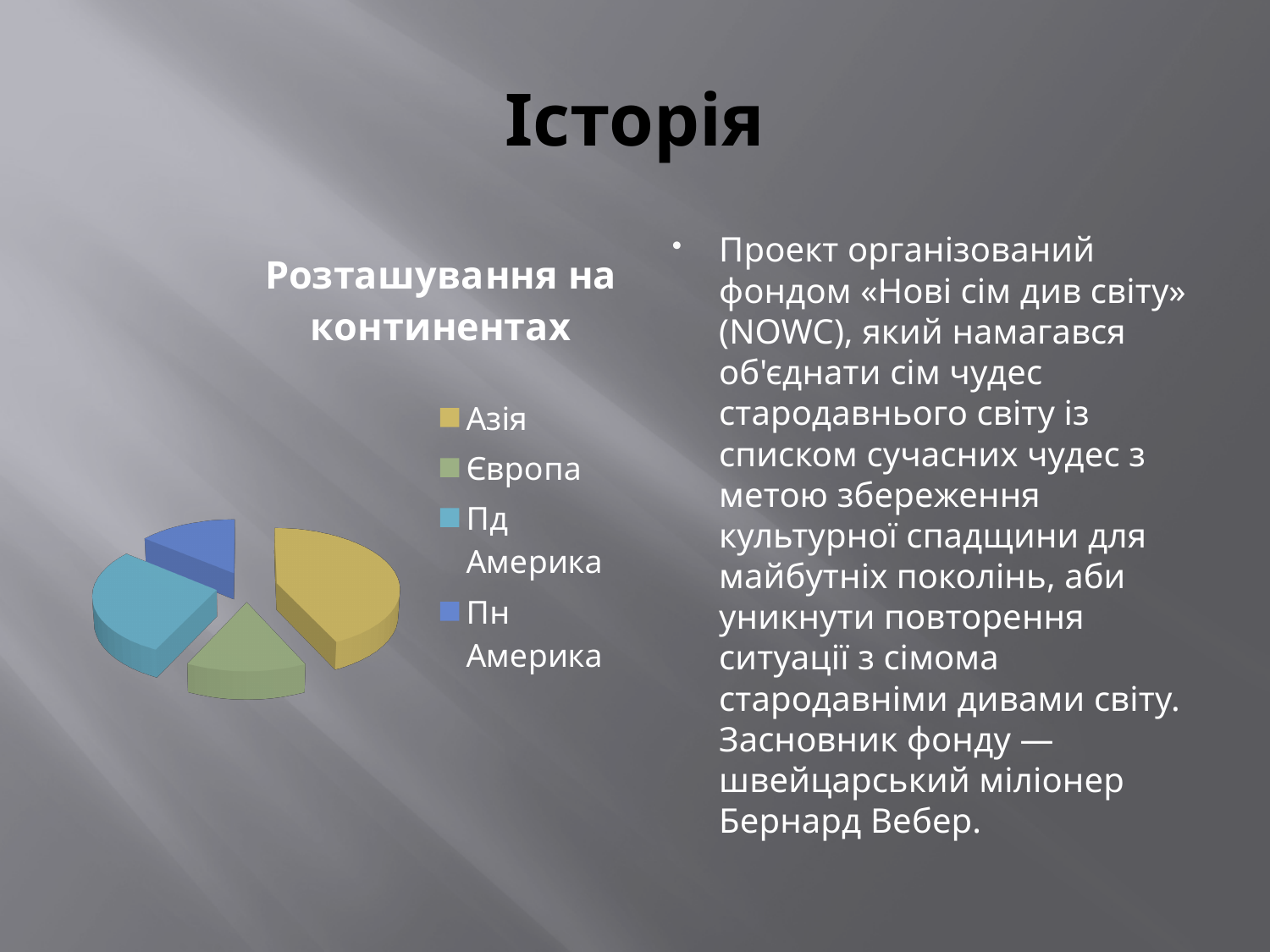
Which slice is larger, Пд Америка or Пн Америка? Пд Америка Which slice is larger, Азія or Пд Америка? Азія Which slice is larger, Азія or Європа? Азія Which category has the largest slice of the pie? Азія How many categories does the pie chart have? 4 What colour is the slice for Азія in the pie chart? yellow What is the title of the chart? Розташування на континентах What kind of chart is shown on the slide? pie chart